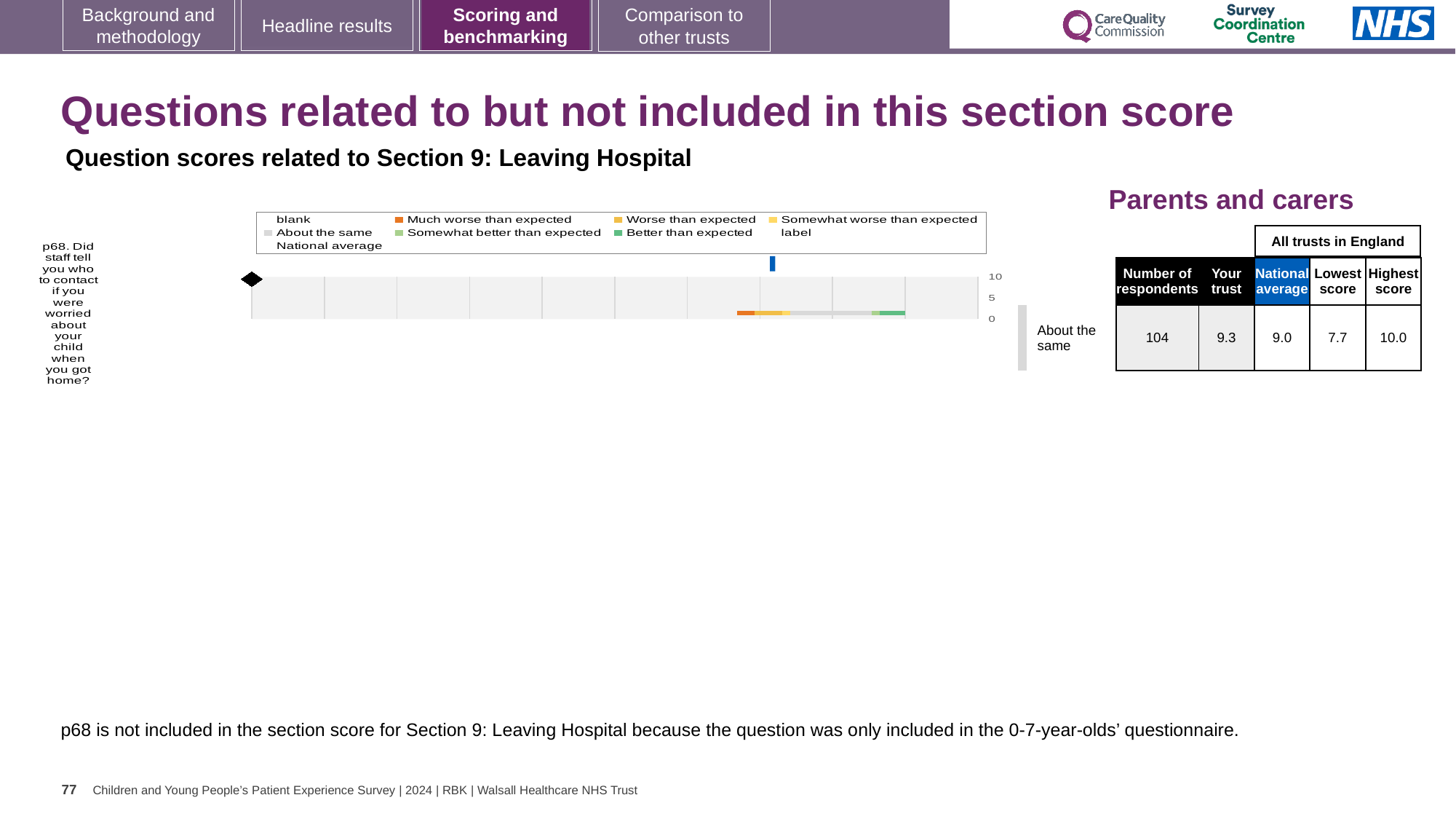
What is the number of respondents for p68? 104 What is the 'Your trust' score for p68 in the table? 9.3 How many entries does the chart legend list? 9 Which question is plotted in the chart? p68. Did staff tell you who to contact if you were worried about your child when you got home? Which legend entry is shown in orange? Much worse than expected Which legend entry is shown in dark green? Better than expected What kind of chart is shown for question p68? bar chart What is the national average score for p68 in the table? 9.0 What is the highest tick value shown on the chart's numeric axis? 10 What benchmark category is given for the trust's score on p68? About the same What is the difference between the highest score and the lowest score for p68 in the table? 2.3 How many questions (categories) are plotted in the chart? 1